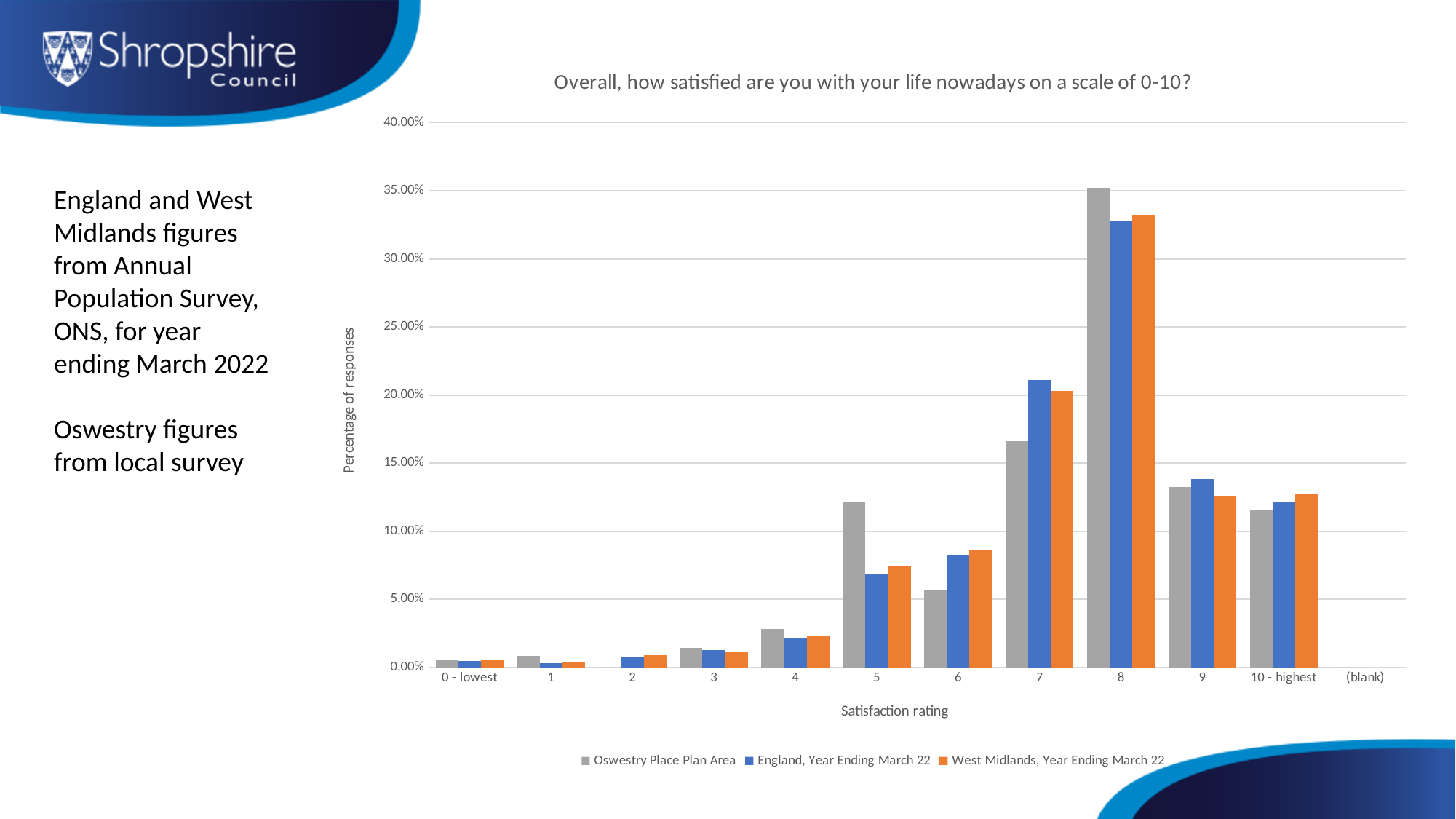
What is the title of the chart? Overall, how satisfied are you with your life nowadays on a scale of 0-10? How many series does the chart legend list? 3 Is the Oswestry Place Plan Area value for rating 8 greater or less than 30.00%? greater Which satisfaction rating has the highest value for the England, Year Ending March 22 series? 8 Is the England, Year Ending March 22 value for rating 7 greater or less than 20.00%? greater At rating 5, which series has the larger value: Oswestry Place Plan Area or England, Year Ending March 22? Oswestry Place Plan Area What type of chart is shown on the slide? Bar chart Do the values for the West Midlands, Year Ending March 22 series rise or fall from rating 5 to rating 8? Rise At rating 7, which series has the larger value: Oswestry Place Plan Area or England, Year Ending March 22? England, Year Ending March 22 Is the England, Year Ending March 22 value for rating 5 greater or less than 10.00%? less How many satisfaction rating categories are shown on the x axis? 12 Which satisfaction rating has the highest value for the Oswestry Place Plan Area series? 8